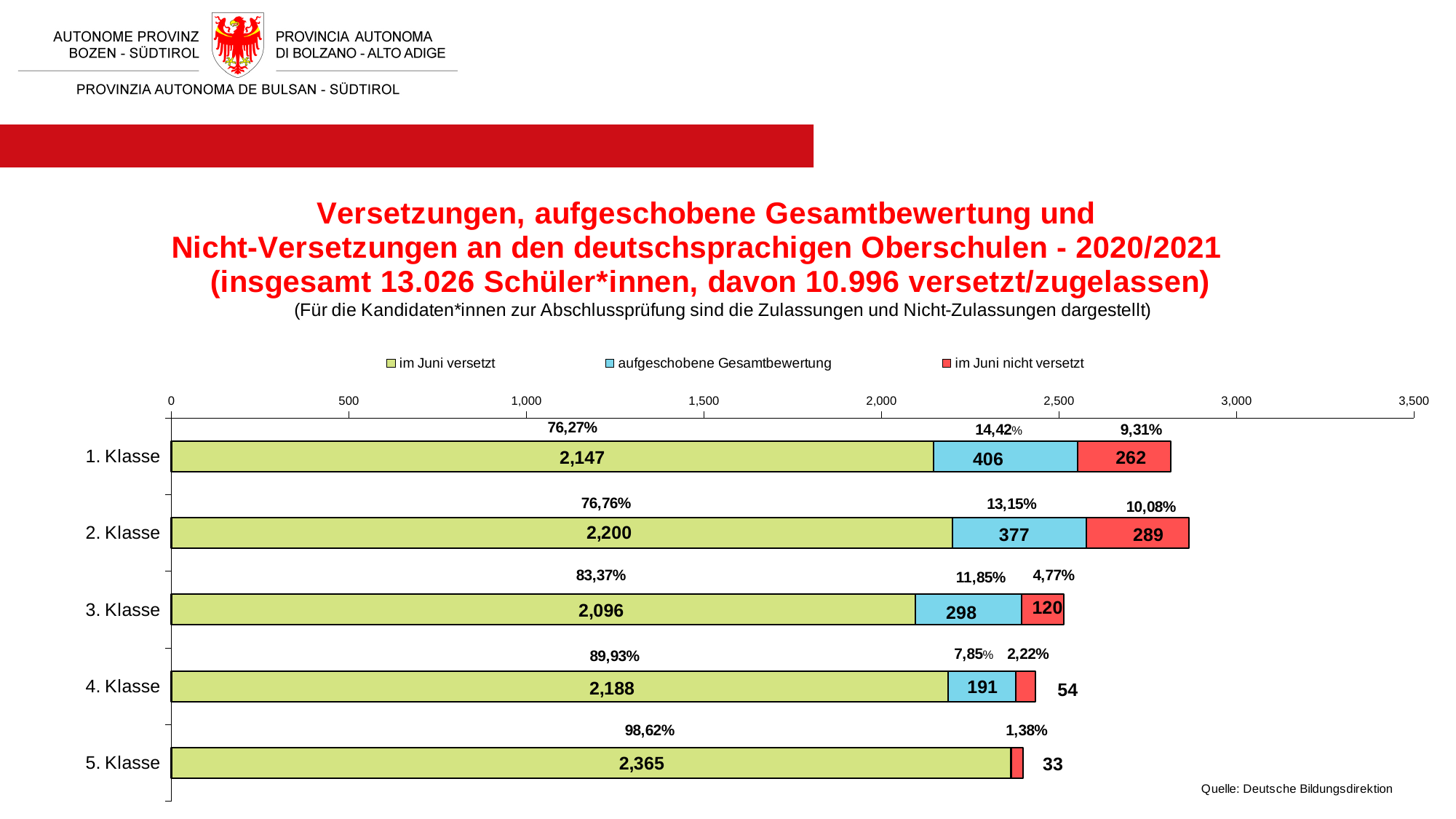
How many classes (categories) are shown on the chart? 5 What is the difference between the 'im Juni nicht versetzt' values for 2. Klasse and 1. Klasse? 27 Which class has the lowest number of students 'im Juni nicht versetzt'? 5. Klasse Which class has the highest number of students 'im Juni versetzt'? 5. Klasse How many series does the legend list? 3 What is the value for 'aufgeschobene Gesamtbewertung' in 2. Klasse? 377 How many students in 3. Klasse were 'im Juni nicht versetzt'? 120 What type of chart is shown on the slide? Stacked bar chart What percentage of 4. Klasse students were 'im Juni versetzt'? 89,93% How many students in 1. Klasse were 'im Juni versetzt'? 2,147 What is the total of the stacked bar for 2. Klasse? 2,866 Which is larger: the 'aufgeschobene Gesamtbewertung' value for 1. Klasse or for 3. Klasse? 1. Klasse